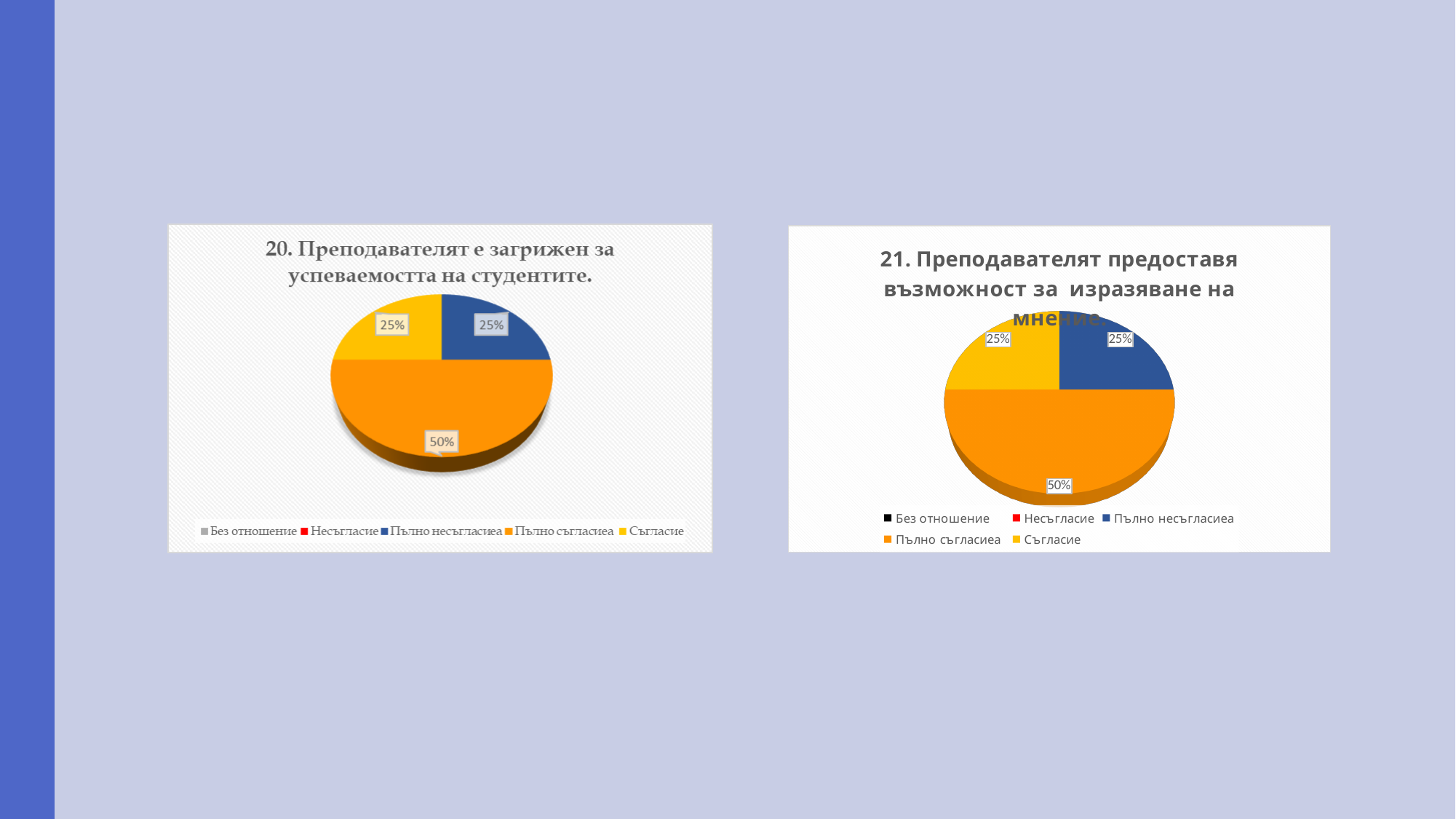
In the right chart (21. Преподавателят предоставя възможност за изразяване на мнение), what colour is the Съгласие slice? Yellow In the right chart (21. Преподавателят предоставя възможност за изразяване на мнение), what share does the Пълно съгласиеа slice have? 50% In the left chart (20. Преподавателят е загрижен за успеваемостта на студентите), what is the difference between the Пълно съгласиеа slice and the Пълно несъгласиеа slice? 25% In the left chart (20. Преподавателят е загрижен за успеваемостта на студентите), what share does the Съгласие slice have? 25% In the left chart (20. Преподавателят е загрижен за успеваемостта на студентите), what share does the Пълно съгласиеа slice have? 50% What kind of chart is the left chart (20. Преподавателят е загрижен за успеваемостта на студентите)? Pie chart In the right chart (21. Преподавателят предоставя възможност за изразяване на мнение), which is larger: the Пълно съгласиеа slice or the Съгласие slice? Пълно съгласиеа In the left chart (20. Преподавателят е загрижен за успеваемостта на студентите), which category has the largest slice? Пълно съгласиеа How many entries does the legend of the left chart (20. Преподавателят е загрижен за успеваемостта на студентите) list? 5 How many slices with data labels are shown in the right chart (21. Преподавателят предоставя възможност за изразяване на мнение)? 3 What kind of chart is the right chart (21. Преподавателят предоставя възможност за изразяване на мнение)? Pie chart